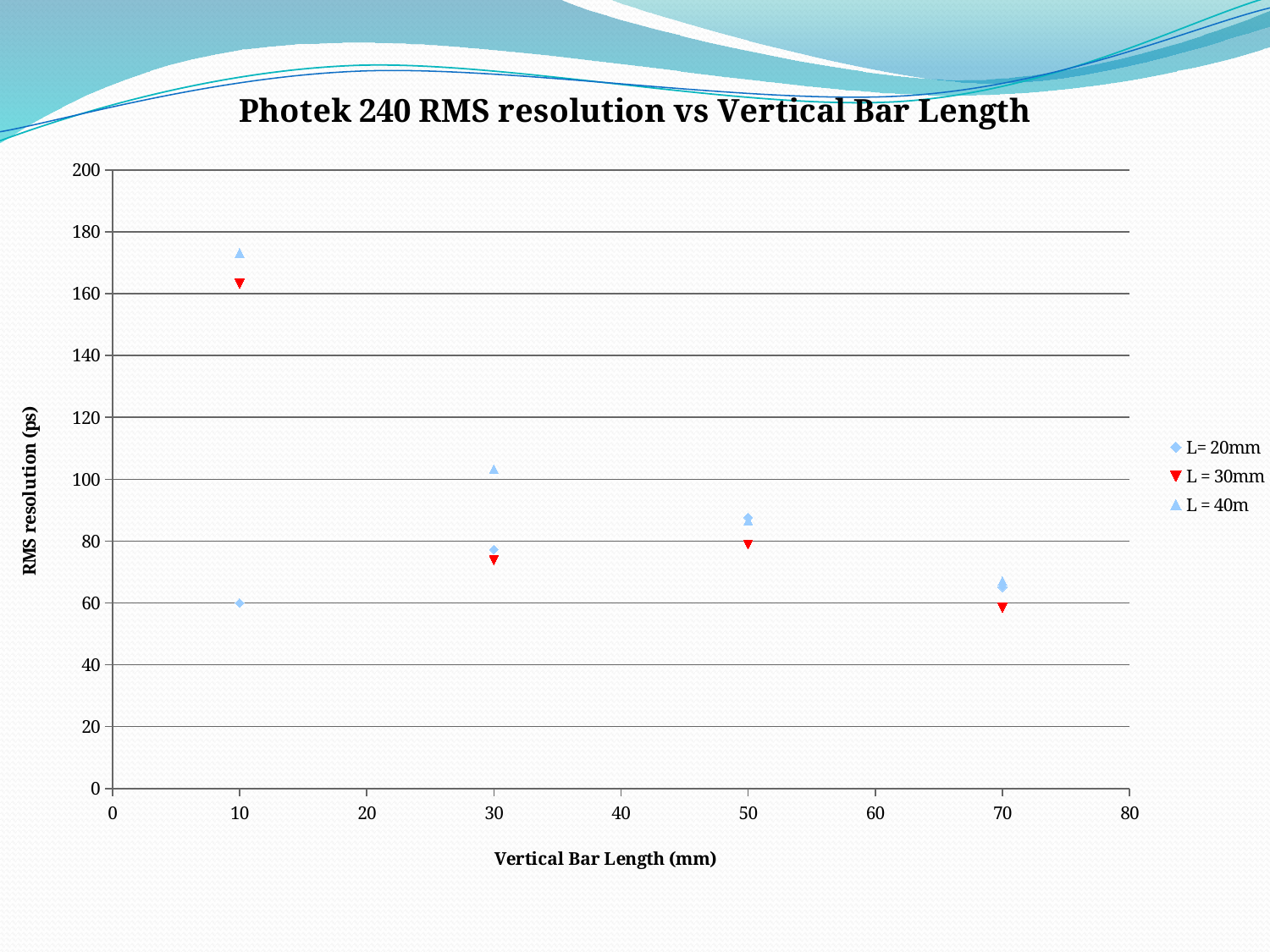
What kind of chart is shown on the slide? scatter chart For the L = 30mm series, at which vertical bar length is the RMS resolution lowest? 70 How many series does the legend list? 3 Is the RMS resolution for L = 30mm at a vertical bar length of 70 mm greater or less than 80? less Is the RMS resolution for L= 20mm at a vertical bar length of 10 mm greater or less than 80? less Is the RMS resolution for L = 30mm at a vertical bar length of 10 mm greater or less than 140? greater At a vertical bar length of 10 mm, which series has the higher RMS resolution, L = 40m or L = 30mm? L = 40m At a vertical bar length of 30 mm, which series has the higher RMS resolution, L = 40m or L= 20mm? L = 40m At how many vertical bar lengths are data points plotted? 4 For the L = 40m series, at which vertical bar length is the RMS resolution highest? 10 What is the title of the x axis? Vertical Bar Length (mm)